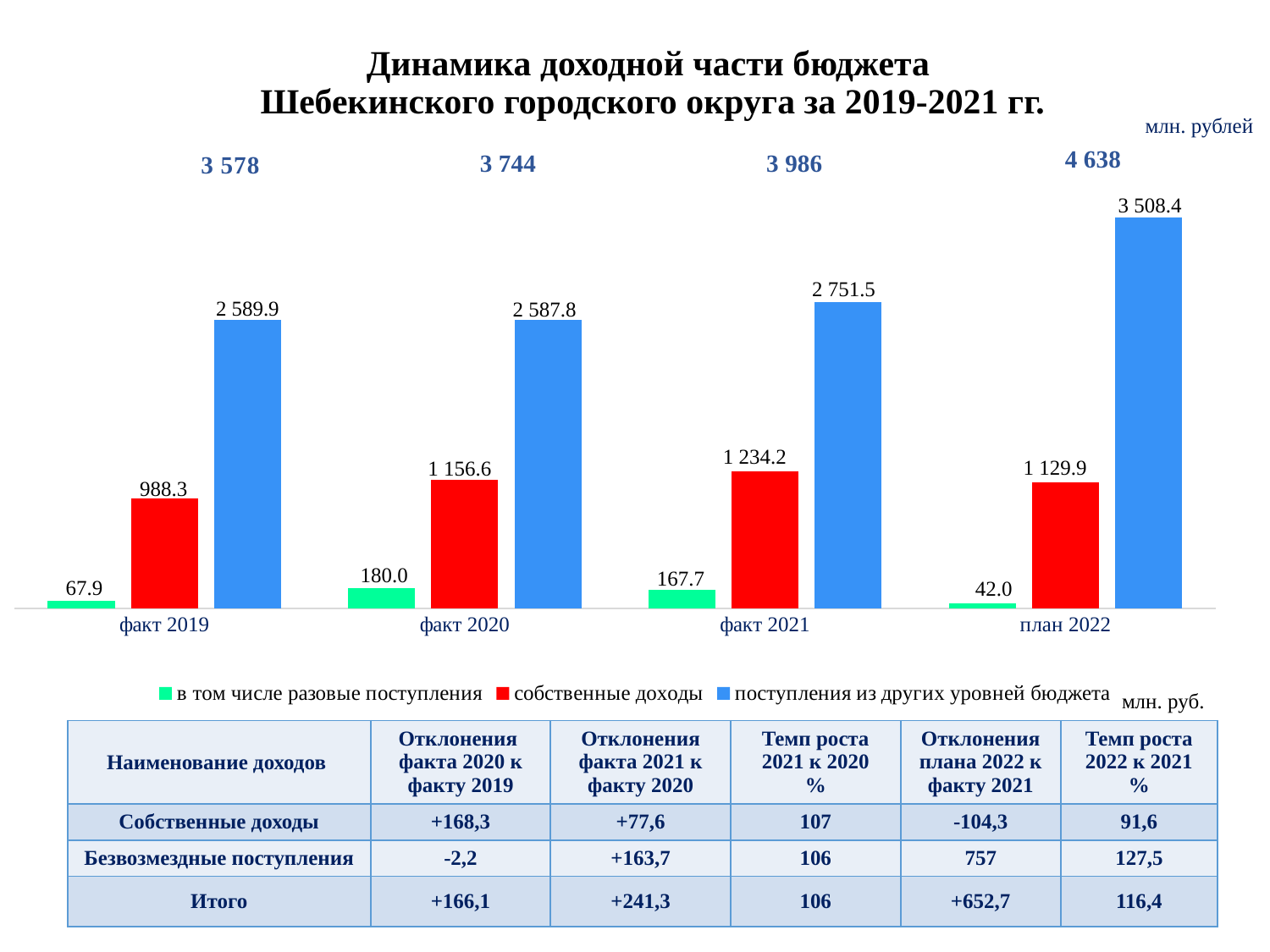
Which category has the highest value for поступления из других уровней бюджета? план 2022 What is the value of поступления из других уровней бюджета for план 2022? 3 508.4 Which category has the highest value for собственные доходы? факт 2021 What is the value of собственные доходы for факт 2021? 1 234.2 What kind of chart is shown on the slide? bar chart What is the value of в том числе разовые поступления for факт 2020? 180.0 Which colour represents собственные доходы in the chart? red Which category has the lowest value for в том числе разовые поступления? план 2022 How many series does the chart legend list? 3 Which is larger: собственные доходы for факт 2021 or for план 2022? факт 2021 What is the difference between собственные доходы for факт 2020 and факт 2019? 168.3 How many categories are shown on the x axis of the chart? 4